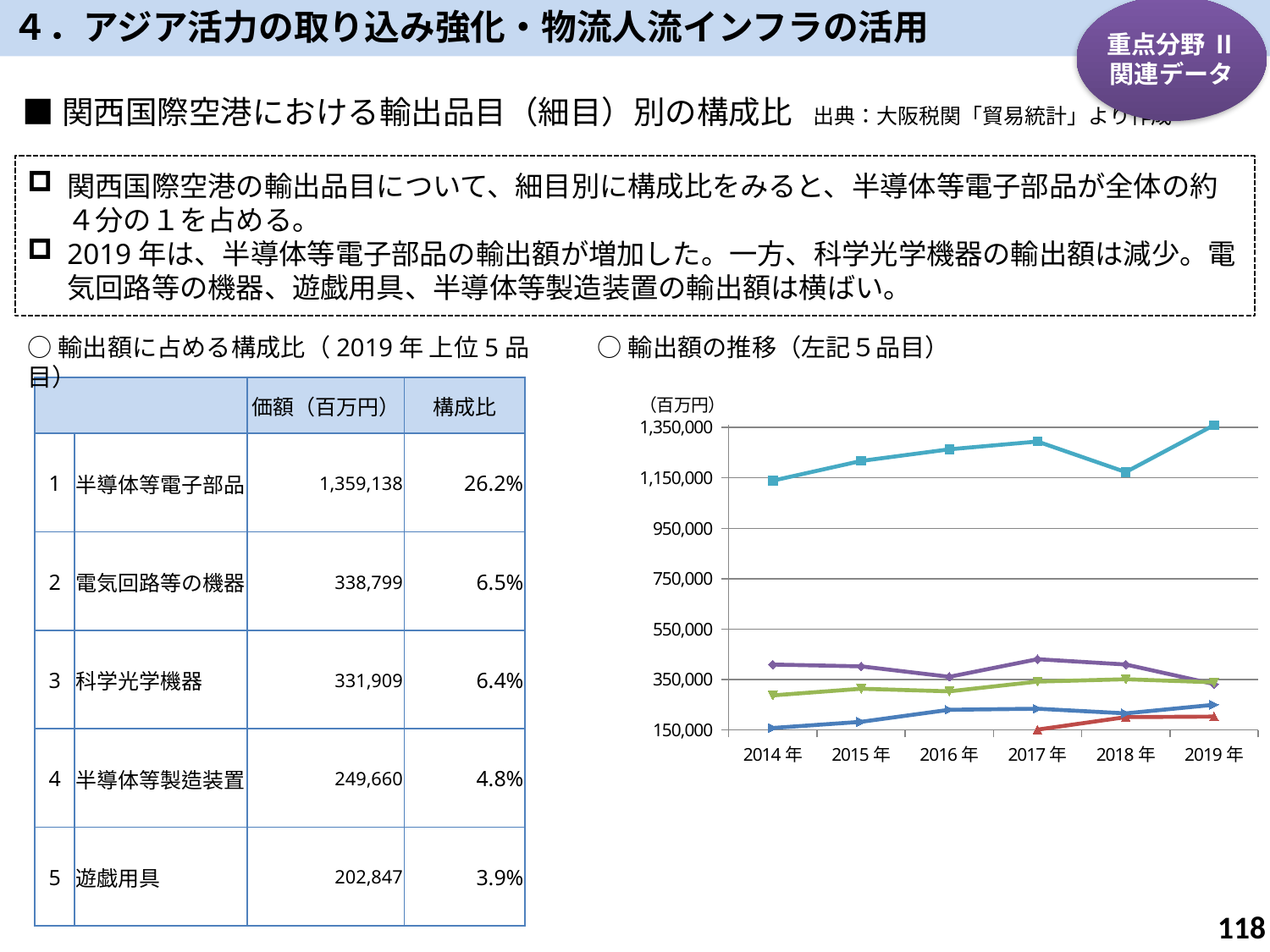
How many lines are plotted in the 輸出額の推移 chart? 5 In the 輸出額の推移 chart, does the topmost line rise or fall between 2017年 and 2018年? fall In the 輸出額の推移 chart, does the topmost line rise or fall from 2014年 to 2019年 overall? rise In the 輸出額の推移 chart, is the value of the red line in 2017年 greater or less than 350,000? less In the 輸出額の推移 chart, which is higher in 2017年, the purple line or the green line? the purple line What unit label is shown at the top of the y axis of the 輸出額の推移 chart? （百万円） In the 輸出額の推移 chart, which year has the highest value for the topmost (light blue) line? 2019年 How many years are plotted along the x axis of the 輸出額の推移 chart? 6 What is the highest tick value shown on the y axis of the 輸出額の推移 chart? 1,350,000 What kind of chart is shown under the title 輸出額の推移（左記５品目）? line chart In the 輸出額の推移 chart, is the value of the purple line in 2017年 greater or less than 350,000? greater In the 輸出額の推移 chart, is the value of the topmost line in 2016年 greater or less than 1,150,000? greater